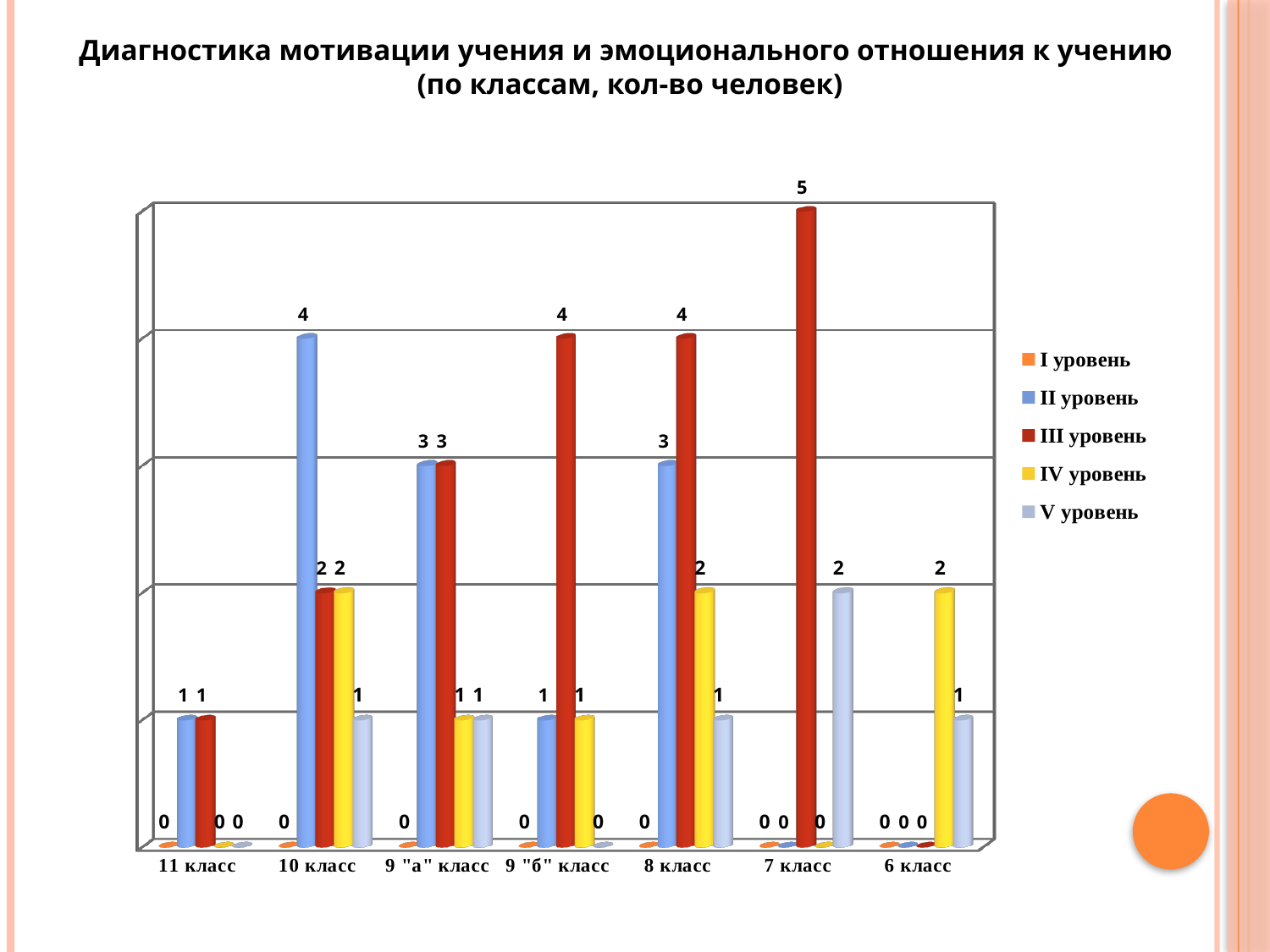
How many classes (categories) are shown on the x axis? 7 What kind of chart is shown on the slide? bar chart Which class has the highest value for III уровень? 7 класс In 8 класс, what is the difference between III уровень and II уровень? 1 What is the value for IV уровень in 6 класс? 2 In 10 класс, which is larger: II уровень or III уровень? II уровень What is the value for V уровень in 7 класс? 2 How many series does the legend list? 5 What is the first entry in the legend? I уровень What is the value for III уровень in 7 класс? 5 Which series has the highest value in 9 "б" класс? III уровень What is the value for II уровень in 10 класс? 4